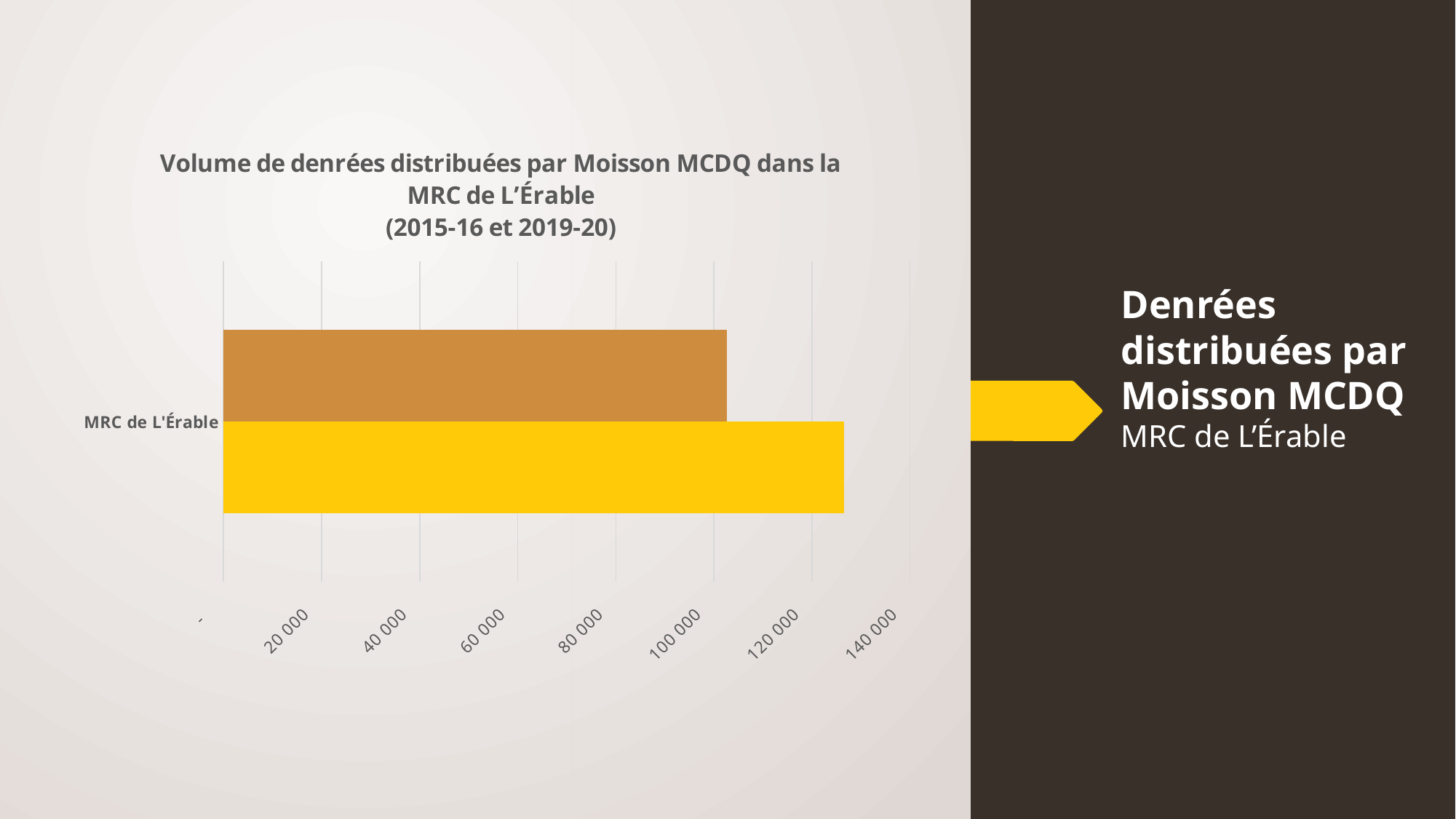
Is the value of the yellow bar greater or less than 120 000? greater What is the highest value shown on the horizontal axis? 140 000 What kind of chart is shown on the slide? bar chart Which bar is longer, the brown bar or the yellow bar? the yellow bar How many categories are shown on the vertical axis of the chart? 1 Is the value of the brown bar greater or less than 100 000? greater How many bars are plotted in the chart? 2 Is the value of the yellow bar greater or less than 140 000? less What is the title of the chart? Volume de denrées distribuées par Moisson MCDQ dans la MRC de L'Érable (2015-16 et 2019-20) What is the label of the category shown on the vertical axis? MRC de L'Érable